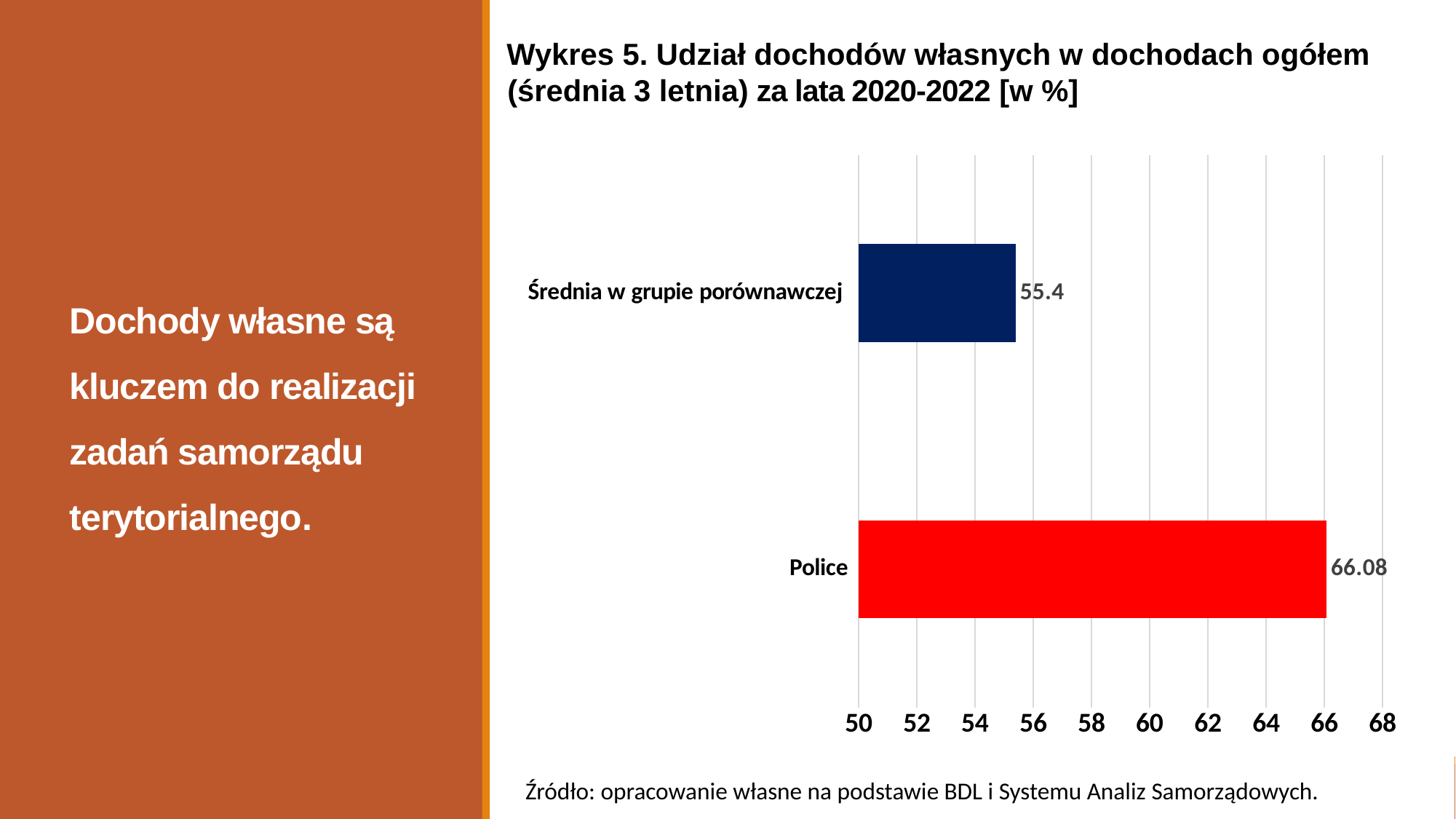
What is the value for Średnia w grupie porównawczej? 55.4 What is the title of the chart? Wykres 5. Udział dochodów własnych w dochodach ogółem (średnia 3 letnia) za lata 2020-2022 [w %] What is the value for Police? 66.08 What kind of chart is shown on the slide? Bar chart Which category has the lowest value? Średnia w grupie porównawczej Which category has the highest value? Police Which is larger, the value for Police or the value for Średnia w grupie porównawczej? Police What is the difference between the value for Police and the value for Średnia w grupie porównawczej? 10.68 Is the value for Police greater or less than 60? greater Is the value for Średnia w grupie porównawczej greater or less than 58? less How many categories are shown in the chart? 2 What colour is the bar for Police? Red